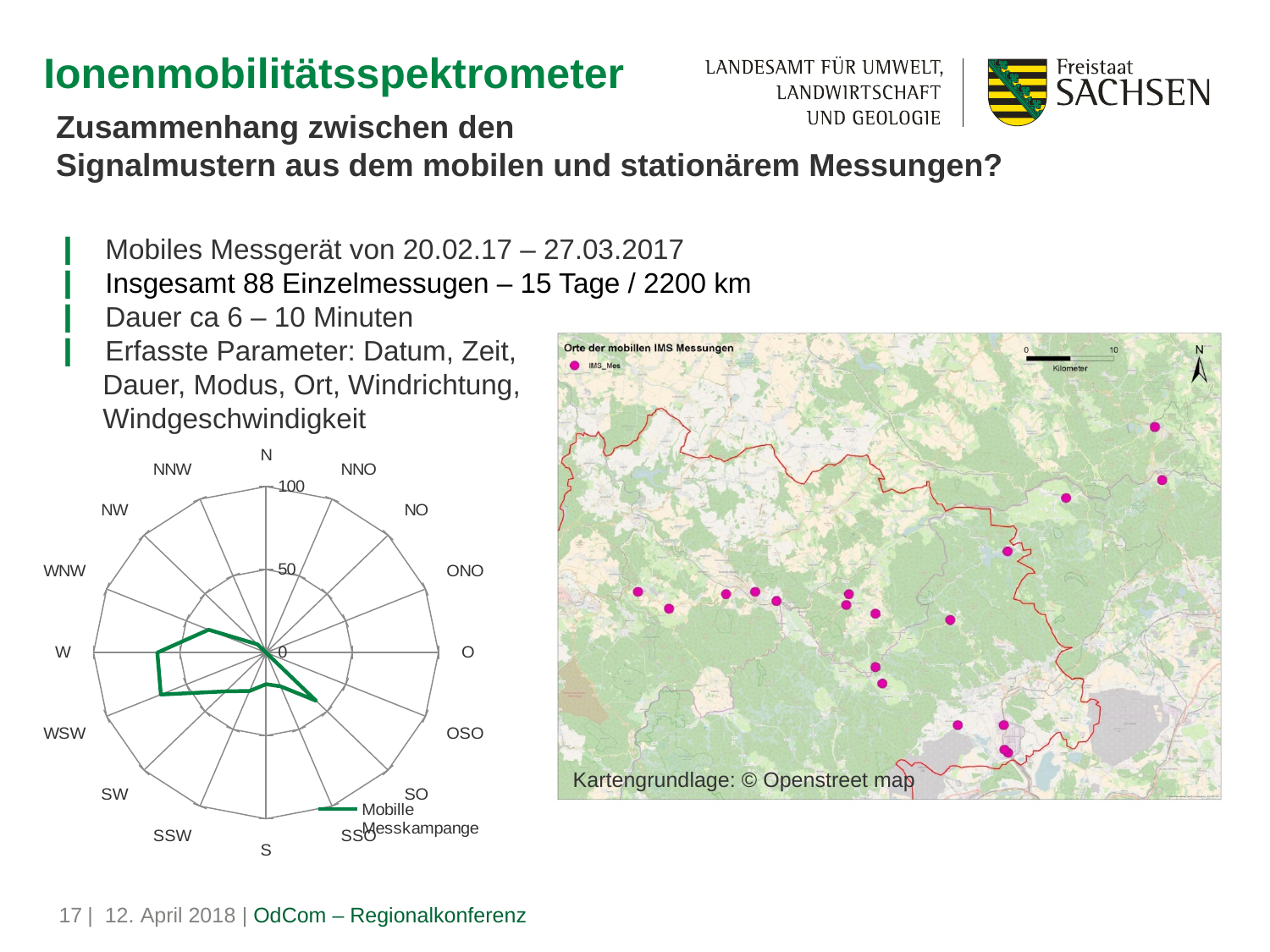
In the radar chart, which is larger, the value for W or the value for OSO? W Is the value for O in the radar chart greater or less than 50? less Is the value for N in the radar chart greater or less than 50? less Is the value for OSO in the radar chart greater or less than 50? less What kind of chart is shown on the left of the slide? radar chart Which direction has the highest value in the radar chart? WSW What is the maximum value shown on the radial axis of the radar chart? 100 What is the name of the series shown in the radar chart legend? Mobille Messkampange In the radar chart, which is larger, the value for WSW or the value for NO? WSW How many series does the legend of the radar chart list? 1 How many compass-direction categories does the radar chart have? 16